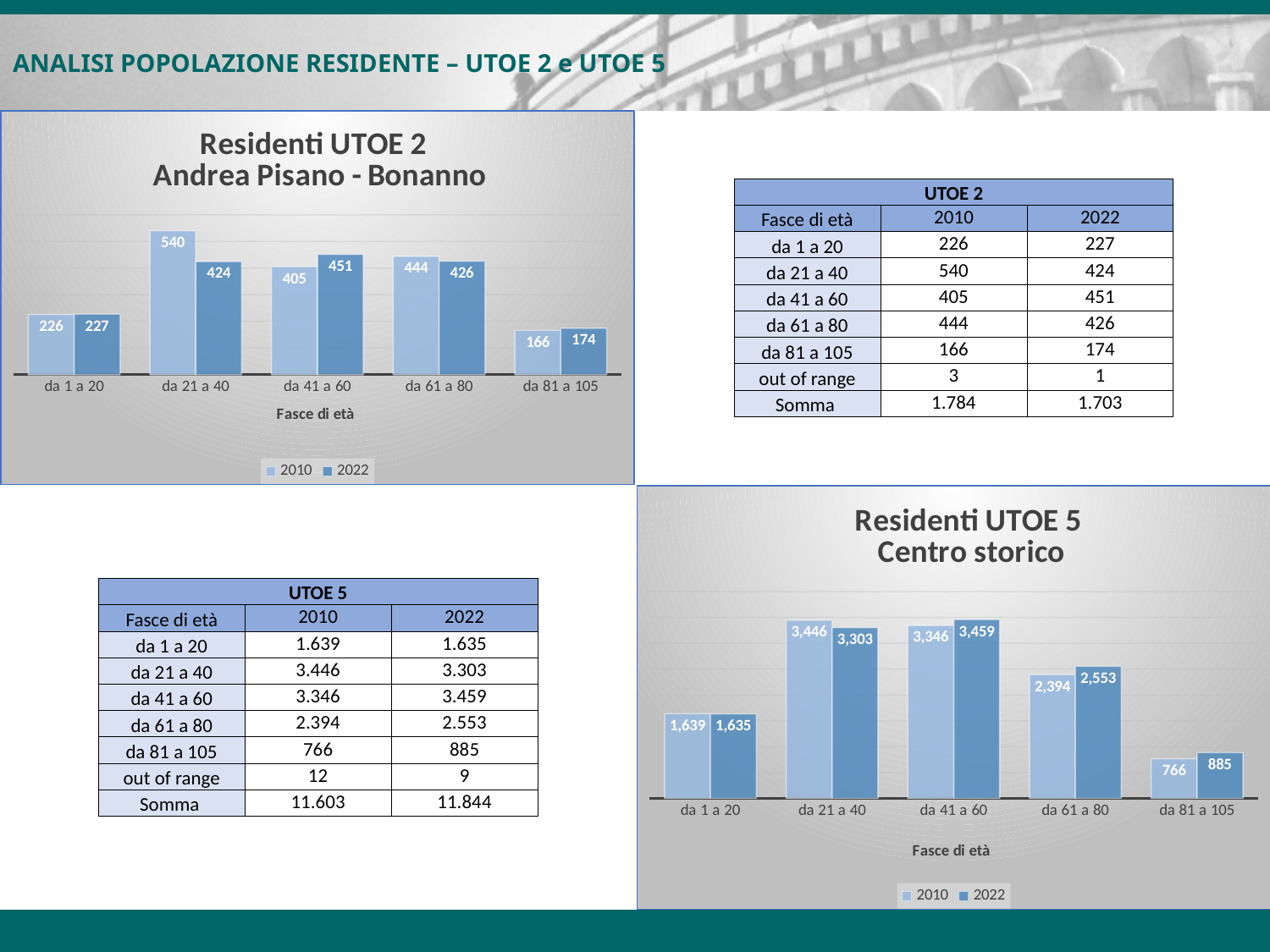
In the 'Residenti UTOE 2 Andrea Pisano - Bonanno' chart, what is the 2022 value for 'da 81 a 105'? 174 In the 'Residenti UTOE 2 Andrea Pisano - Bonanno' chart, which is larger for 'da 41 a 60': the 2010 value or the 2022 value? 2022 In the 'Residenti UTOE 5 Centro storico' chart, what is the difference between the 2022 and 2010 values for 'da 81 a 105'? 119 In the 'Residenti UTOE 5 Centro storico' chart, which age group has the highest 2022 value? da 41 a 60 In the 'Residenti UTOE 2 Andrea Pisano - Bonanno' chart, what is the 2010 value for 'da 21 a 40'? 540 How many series does the legend of the 'Residenti UTOE 5 Centro storico' chart list? 2 In the 'Residenti UTOE 2 Andrea Pisano - Bonanno' chart, which age group has the lowest 2010 value? da 81 a 105 What type of chart is the 'Residenti UTOE 5 Centro storico' chart? Bar chart In the 'Residenti UTOE 5 Centro storico' chart, what is the 2022 value for 'da 41 a 60'? 3,459 In the 'Residenti UTOE 5 Centro storico' chart, what is the 2010 value for 'da 61 a 80'? 2,394 How many age groups are shown on the x axis of the 'Residenti UTOE 2 Andrea Pisano - Bonanno' chart? 5 In the 'Residenti UTOE 2 Andrea Pisano - Bonanno' chart, what is the difference between the 2010 and 2022 values for 'da 21 a 40'? 116